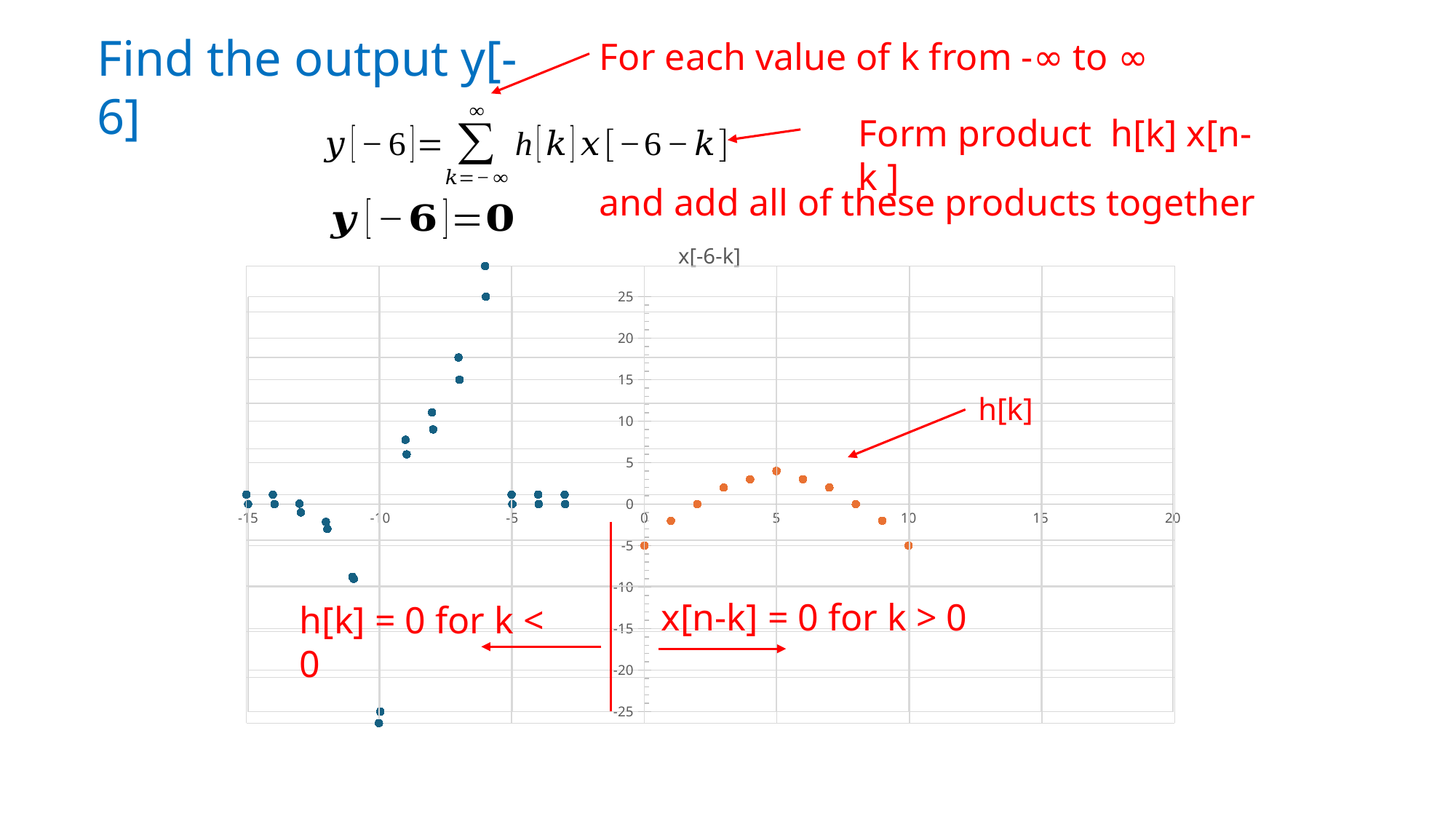
Between k = 0 and k = 5, do the orange h[k] values rise or fall? rise At which value of k does the blue x[-6-k] series reach its highest point? -6 What kind of chart is shown on the slide? scatter chart Is the value of the orange h[k] series at k = 5 greater or less than 0? greater Is the value of the blue x[-6-k] series at k = -11 greater or less than -5? less Which is larger: the orange h[k] value at k = 5 or at k = 8? k = 5 What colour are the h[k] points on the chart? orange What is the title of the chart? x[-6-k] At which value of k does the orange h[k] series reach its highest point? 5 At which value of k does the blue x[-6-k] series reach its lowest point? -10 Is the value of the blue x[-6-k] series at k = -10 greater or less than -20? less